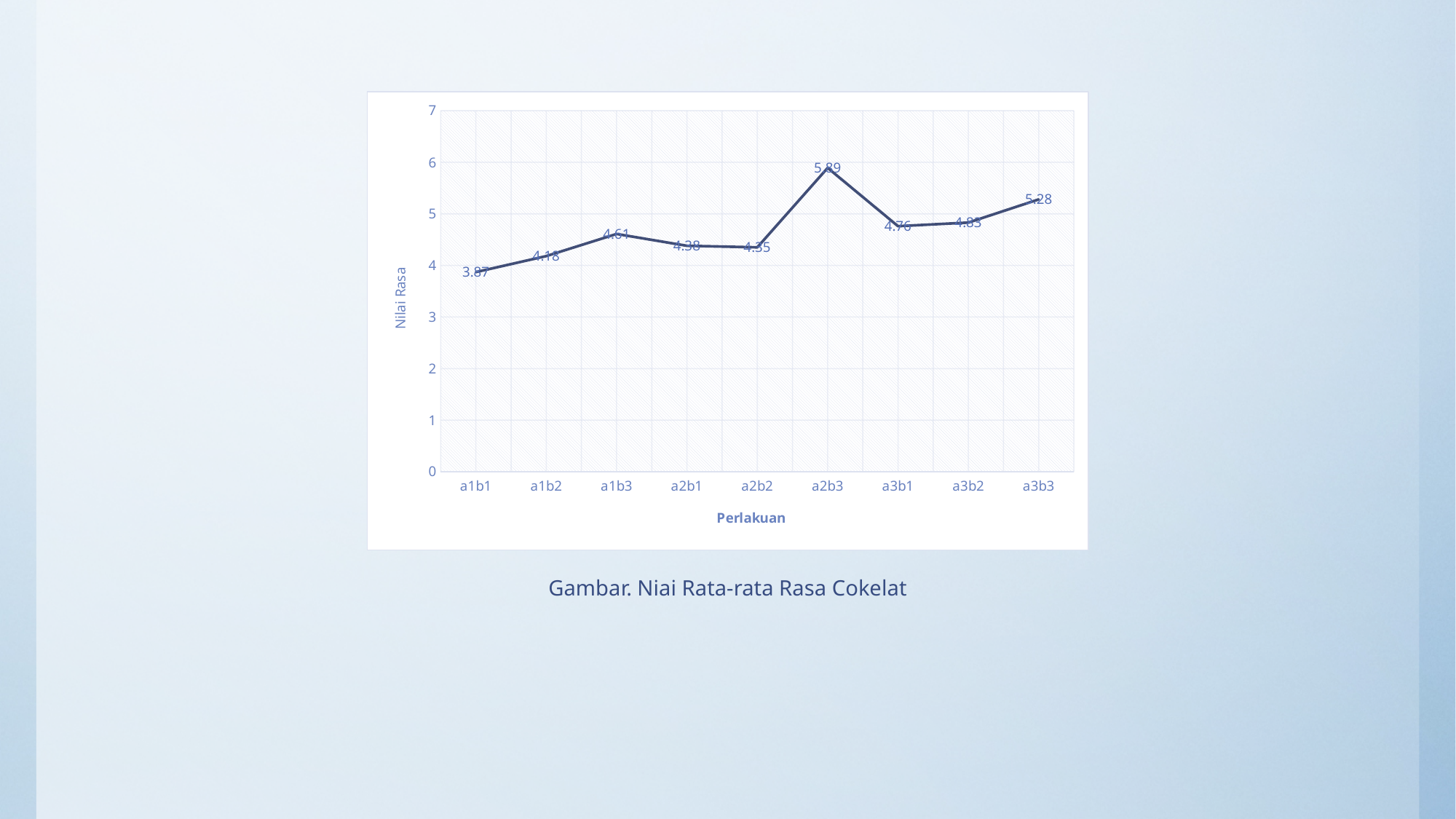
Is the value for a2b3 greater or less than 5? greater What type of chart is shown on the slide? Line chart What is the title of the y axis? Nilai Rasa What is the value for a1b1? 3.87 What is the value for a1b3? 4.61 Which treatment (perlakuan) has the highest value? a2b3 Which treatment (perlakuan) has the lowest value? a1b1 Which has a larger value, a3b3 or a3b1? a3b3 What is the value for a3b3? 5.28 What is the difference between the values for a2b3 and a1b1? 2.02 What is the value for a2b3? 5.89 How many treatments (categories) are plotted on the x axis? 9